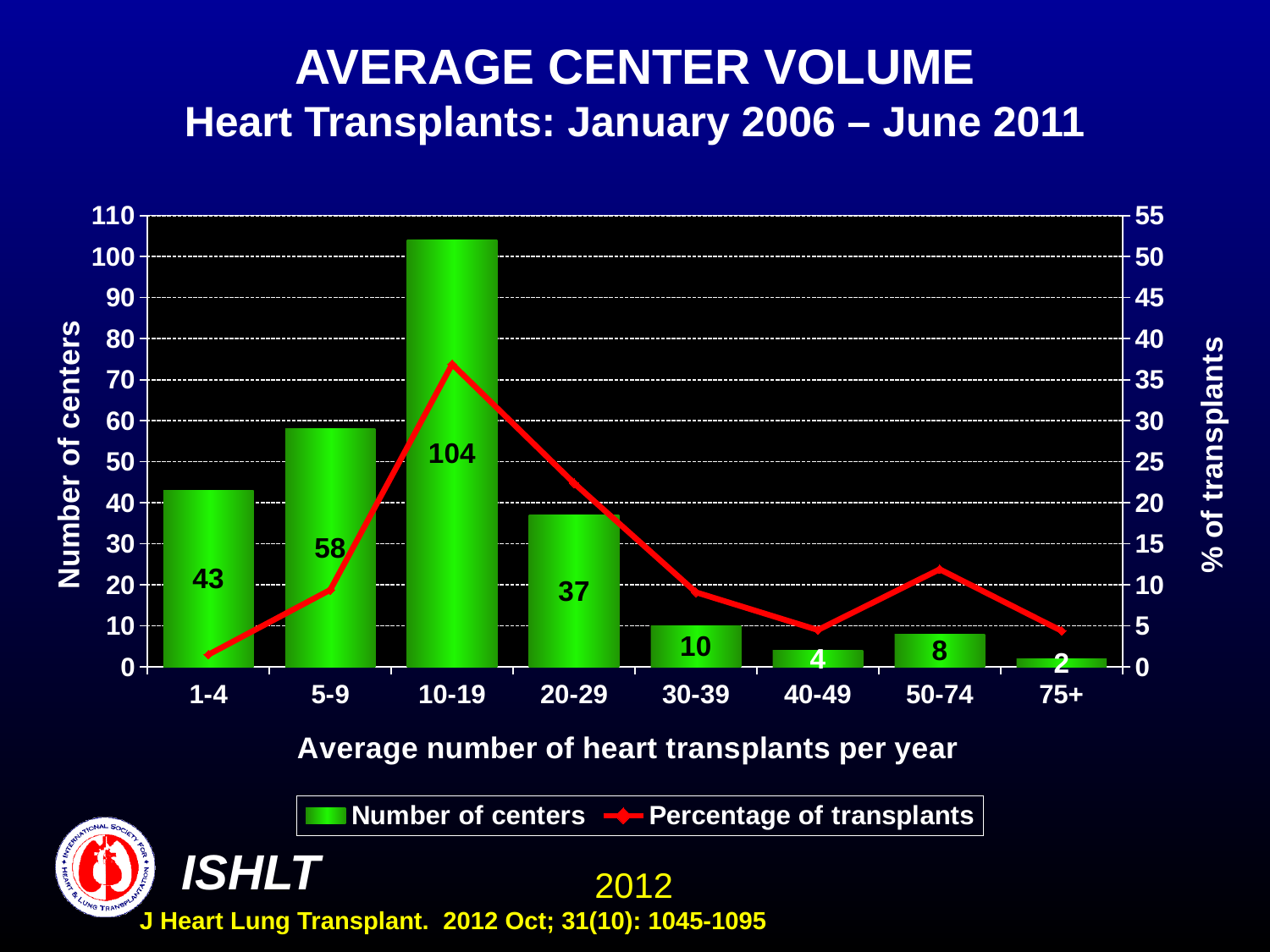
What is the number of centers for the 50-74 category? 8 Is the percentage of transplants for the 1-4 category greater or less than 5? less How many categories are shown on the x axis? 8 How many series does the legend list? 2 How many centers are in the 10-19 category? 104 Which category has the highest number of centers? 10-19 Is the percentage of transplants for the 10-19 category greater or less than 30? greater What is the difference in number of centers between the 10-19 and 5-9 categories? 46 Which has more centers, the 1-4 category or the 20-29 category? 1-4 What is the label of the right-hand y axis? % of transplants Which category has the lowest number of centers? 75+ What is the number of centers for the 1-4 category? 43